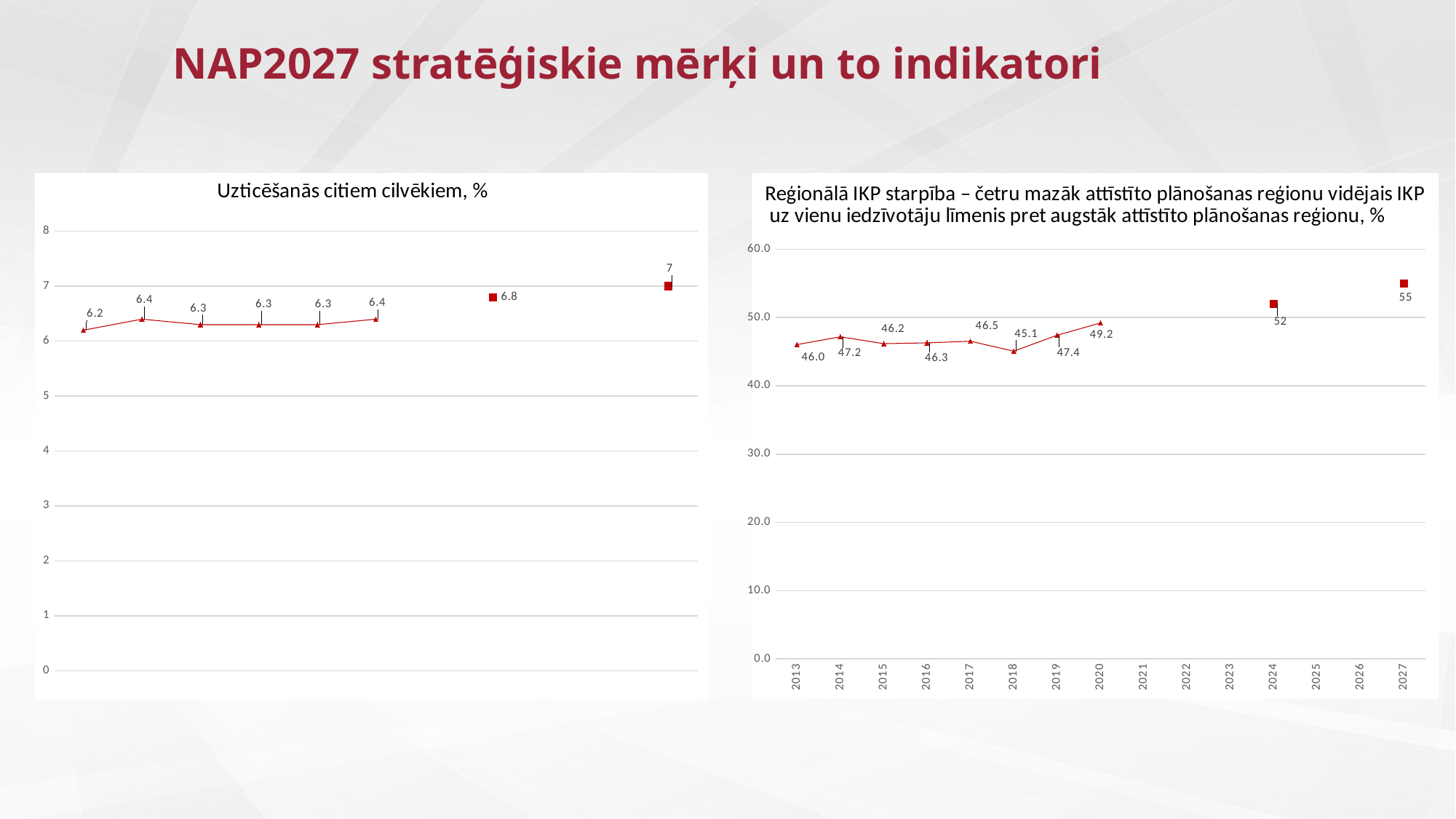
In the right chart (Reģionālā IKP starpība), what is the value for 2020? 49.2 In the left chart (Uzticēšanās citiem cilvēkiem, %), what is the lowest value shown? 6.2 What type of chart is the left chart (Uzticēšanās citiem cilvēkiem, %)? line chart In the right chart (Reģionālā IKP starpība), what is the difference between the 2024 value and the 2020 value? 2.8 In the left chart (Uzticēšanās citiem cilvēkiem, %), how many data points are plotted? 8 In the right chart (Reģionālā IKP starpība), which year has the lowest value? 2018 In the right chart (Reģionālā IKP starpība), is the value for 2013 greater or less than 50.0? less In the right chart (Reģionālā IKP starpība), which is larger, the value for 2014 or the value for 2019? 2019 In the right chart (Reģionālā IKP starpība), what is the value for 2018? 45.1 In the right chart (Reģionālā IKP starpība), which year has the highest value? 2027 In the right chart (Reģionālā IKP starpība), what is the value shown for 2027? 55 In the left chart (Uzticēšanās citiem cilvēkiem, %), what is the highest value shown? 7